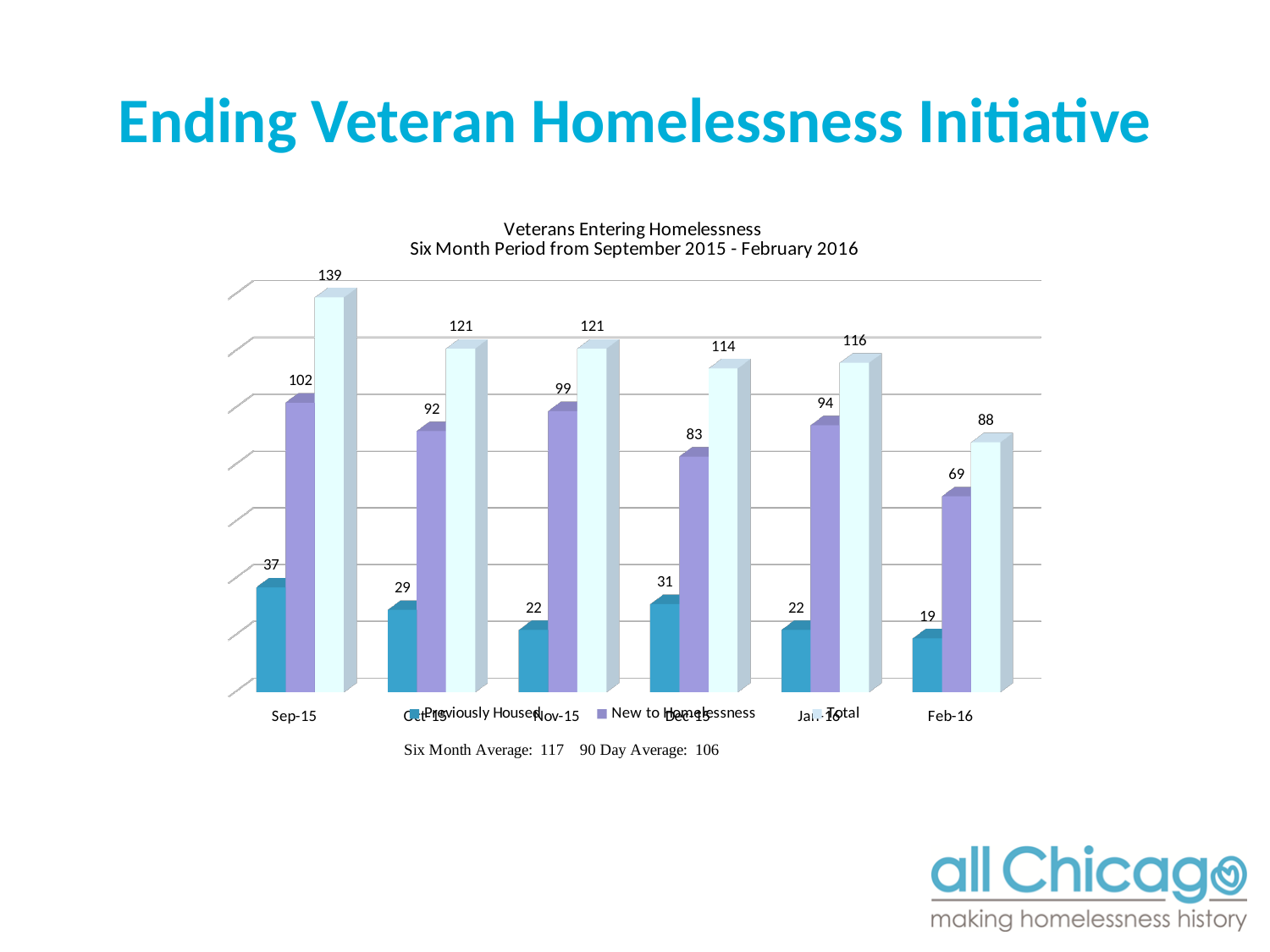
Does the Total value rise or fall from Dec-15 to Jan-16? Rise What is the Six Month Average stated below the chart? 117 Which month has the highest Total value? Sep-15 How many series does the legend list? 3 What kind of chart is shown on the slide? Bar chart What is the Previously Housed value for Feb-16? 19 Which month has the lowest New to Homelessness value? Feb-16 What is the difference between the Total values for Sep-15 and Feb-16? 51 How many months are shown on the x axis? 6 What is the New to Homelessness value for Dec-15? 83 What is the Total value for Sep-15? 139 Which is larger, the New to Homelessness value for Oct-15 or for Nov-15? Nov-15